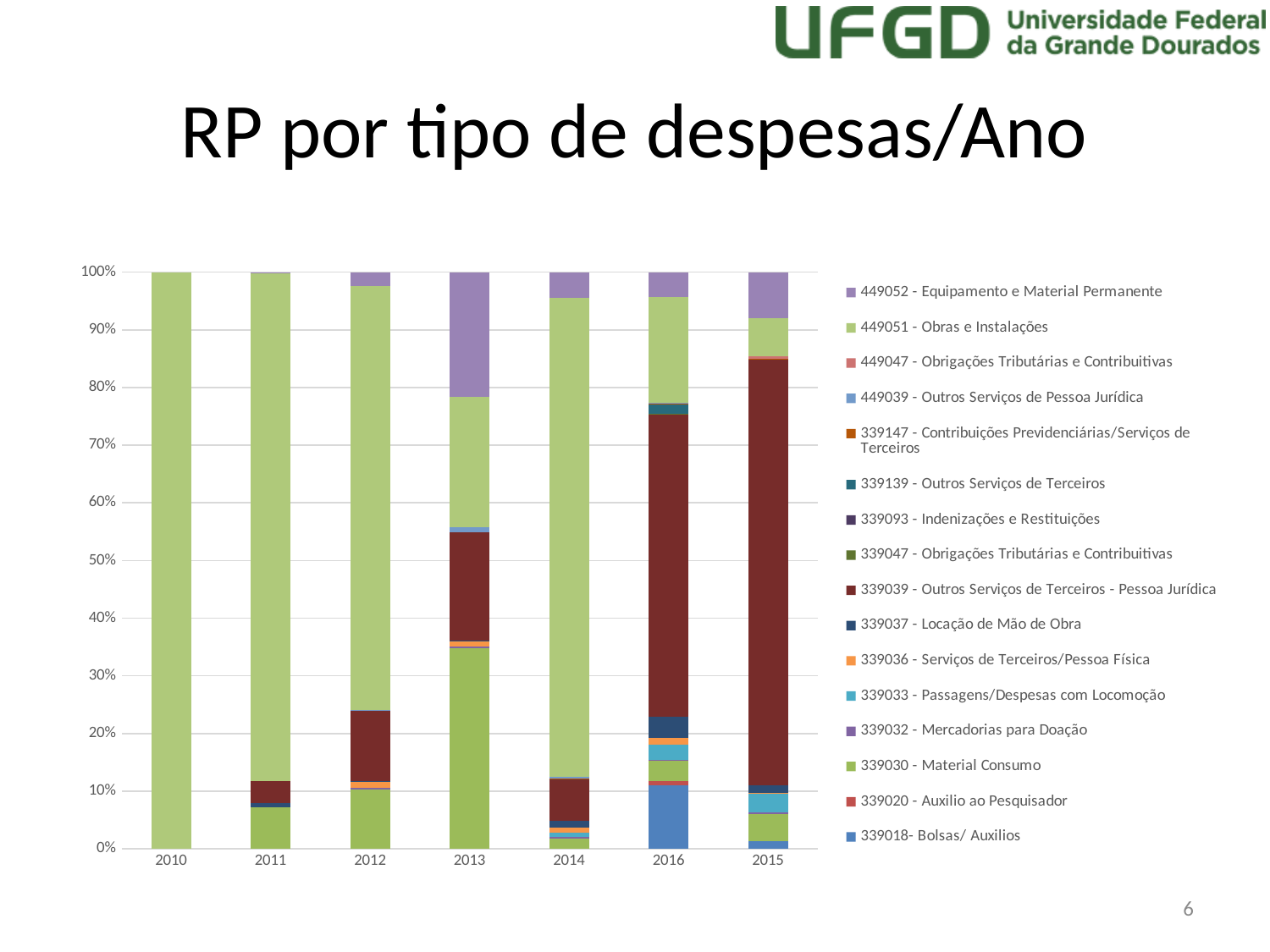
What type of chart is shown on the slide? Stacked bar chart Which year has the largest share for 339039 - Outros Serviços de Terceiros - Pessoa Jurídica? 2015 Is the share of 449052 - Equipamento e Material Permanente in 2013 greater or less than 10%? greater Which category label appears last (rightmost) on the x axis? 2015 In 2016, which is larger: the share of 339039 - Outros Serviços de Terceiros - Pessoa Jurídica or the share of 339030 - Material Consumo? 339039 - Outros Serviços de Terceiros - Pessoa Jurídica Which year has the largest share for 449052 - Equipamento e Material Permanente? 2013 How many years (categories) are shown on the x axis of the chart? 7 What is the title of the slide containing the chart? RP por tipo de despesas/Ano Is the share of 339039 - Outros Serviços de Terceiros - Pessoa Jurídica in 2015 greater or less than 60%? greater Is the share of 449051 - Obras e Instalações in 2010 greater or less than 90%? greater How many series does the chart's legend list? 16